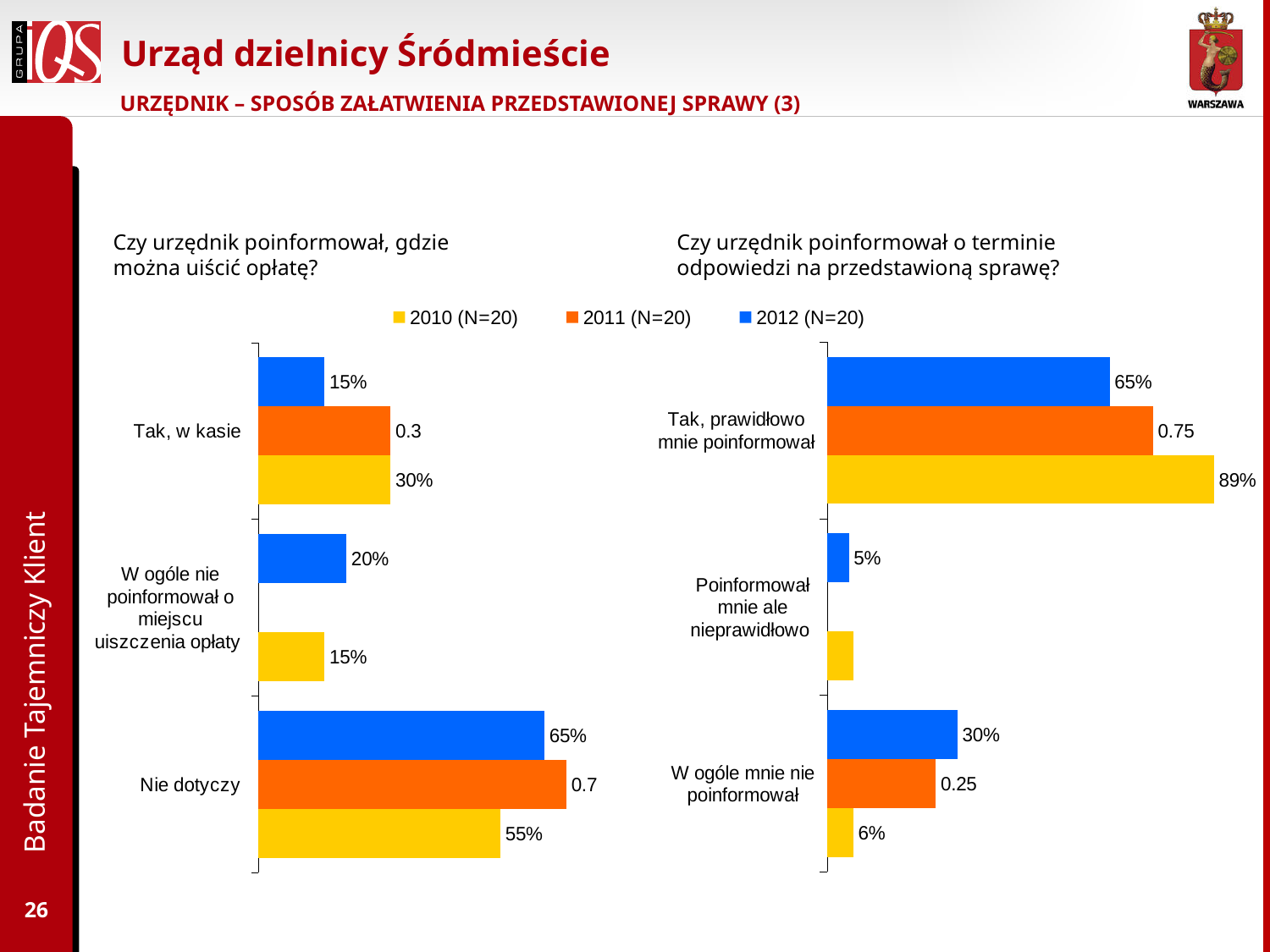
In the right chart (Czy urzędnik poinformował o terminie odpowiedzi na przedstawioną sprawę?), what is the value for 2010 (N=20) in the category "Tak, prawidłowo mnie poinformował"? 89% In the left chart (Czy urzędnik poinformował, gdzie można uiścić opłatę?), what is the difference between the 2012 (N=20) and 2010 (N=20) values for "Nie dotyczy"? 10% How many categories does the left chart (Czy urzędnik poinformował, gdzie można uiścić opłatę?) show? 3 In the right chart (Czy urzędnik poinformował o terminie odpowiedzi na przedstawioną sprawę?), which is larger for "W ogóle mnie nie poinformował": the 2012 (N=20) value or the 2010 (N=20) value? 2012 (N=20) In the right chart (Czy urzędnik poinformował o terminie odpowiedzi na przedstawioną sprawę?), which category has the lowest value for 2012 (N=20)? Poinformował mnie ale nieprawidłowo Which series is shown in blue in the legend? 2012 (N=20) In the left chart (Czy urzędnik poinformował, gdzie można uiścić opłatę?), which category has the highest value for 2012 (N=20)? Nie dotyczy In the left chart (Czy urzędnik poinformował, gdzie można uiścić opłatę?), what value is printed for 2011 (N=20) in the category "Nie dotyczy"? 0.7 In the left chart (Czy urzędnik poinformował, gdzie można uiścić opłatę?), what is the value for 2012 (N=20) in the category "Tak, w kasie"? 15% In the right chart (Czy urzędnik poinformował o terminie odpowiedzi na przedstawioną sprawę?), what value is printed for 2011 (N=20) in the category "W ogóle mnie nie poinformował"? 0.25 What kind of chart is the right chart (Czy urzędnik poinformował o terminie odpowiedzi na przedstawioną sprawę?)? Bar chart How many series does the legend list? 3